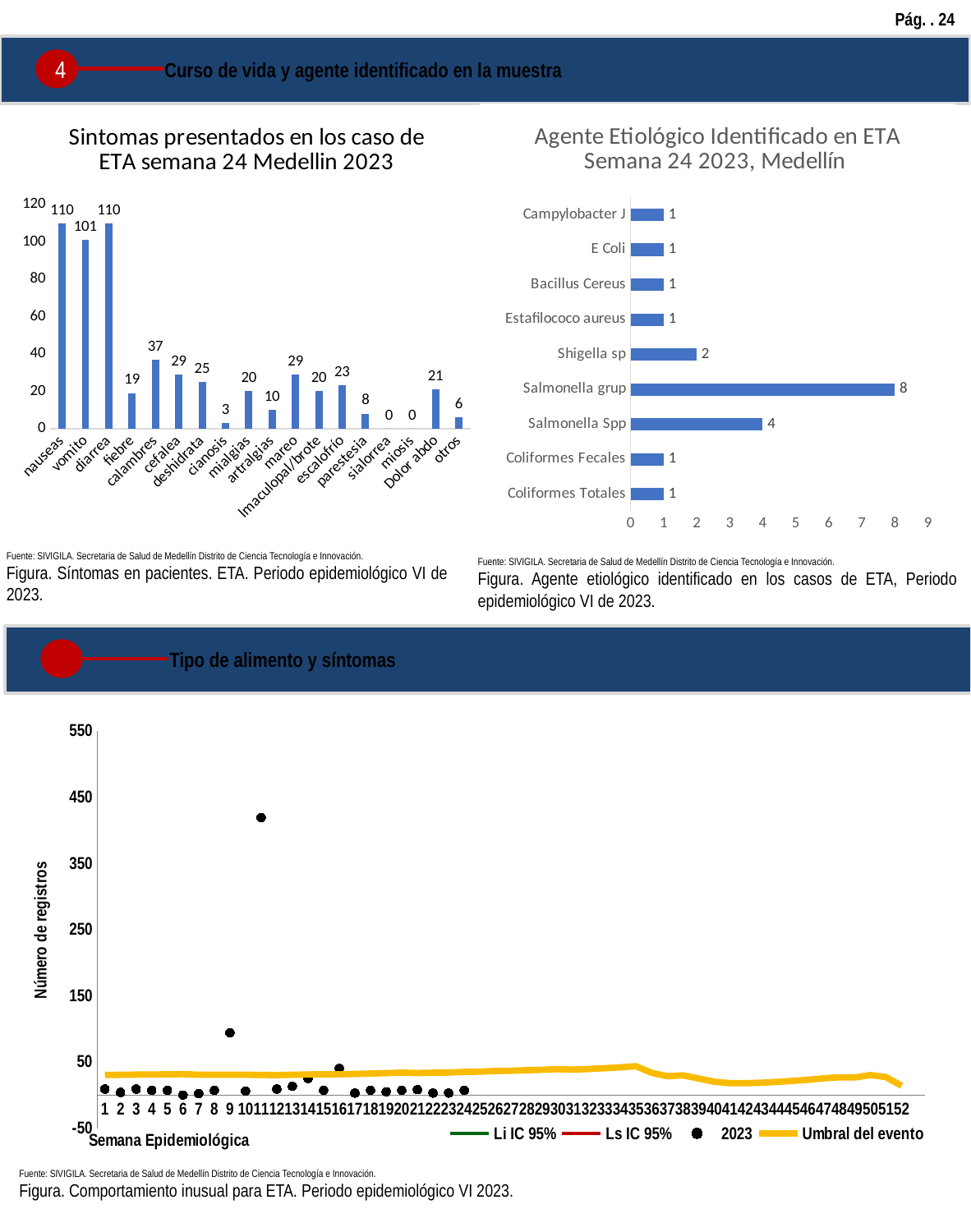
In the chart 'Sintomas presentados en los caso de ETA semana 24 Medellin 2023', what is the difference between fiebre and cianosis? 16 In the chart 'Agente Etiológico Identificado en ETA Semana 24 2023, Medellín', what is the difference between Salmonella grup and Shigella sp? 6 In the chart 'Sintomas presentados en los caso de ETA semana 24 Medellin 2023', what is the value for vomito? 101 In the chart 'Sintomas presentados en los caso de ETA semana 24 Medellin 2023', what is the value for calambres? 37 In the chart 'Sintomas presentados en los caso de ETA semana 24 Medellin 2023', which is larger, escalofrio or Dolor abdo? escalofrio In the chart 'Agente Etiológico Identificado en ETA Semana 24 2023, Medellín', which agent has the highest value? Salmonella grup In the bottom chart (Número de registros vs Semana Epidemiológica), is the 2023 value at week 11 greater or less than 350? greater How many series does the legend list in the bottom chart (Número de registros vs Semana Epidemiológica)? 4 What type of chart is 'Agente Etiológico Identificado en ETA Semana 24 2023, Medellín'? bar chart In the chart 'Agente Etiológico Identificado en ETA Semana 24 2023, Medellín', what is the value for Salmonella Spp? 4 In the chart 'Sintomas presentados en los caso de ETA semana 24 Medellin 2023', which symptoms have a value of 0? sialorrea and miosis How many symptom categories are shown in the chart 'Sintomas presentados en los caso de ETA semana 24 Medellin 2023'? 18